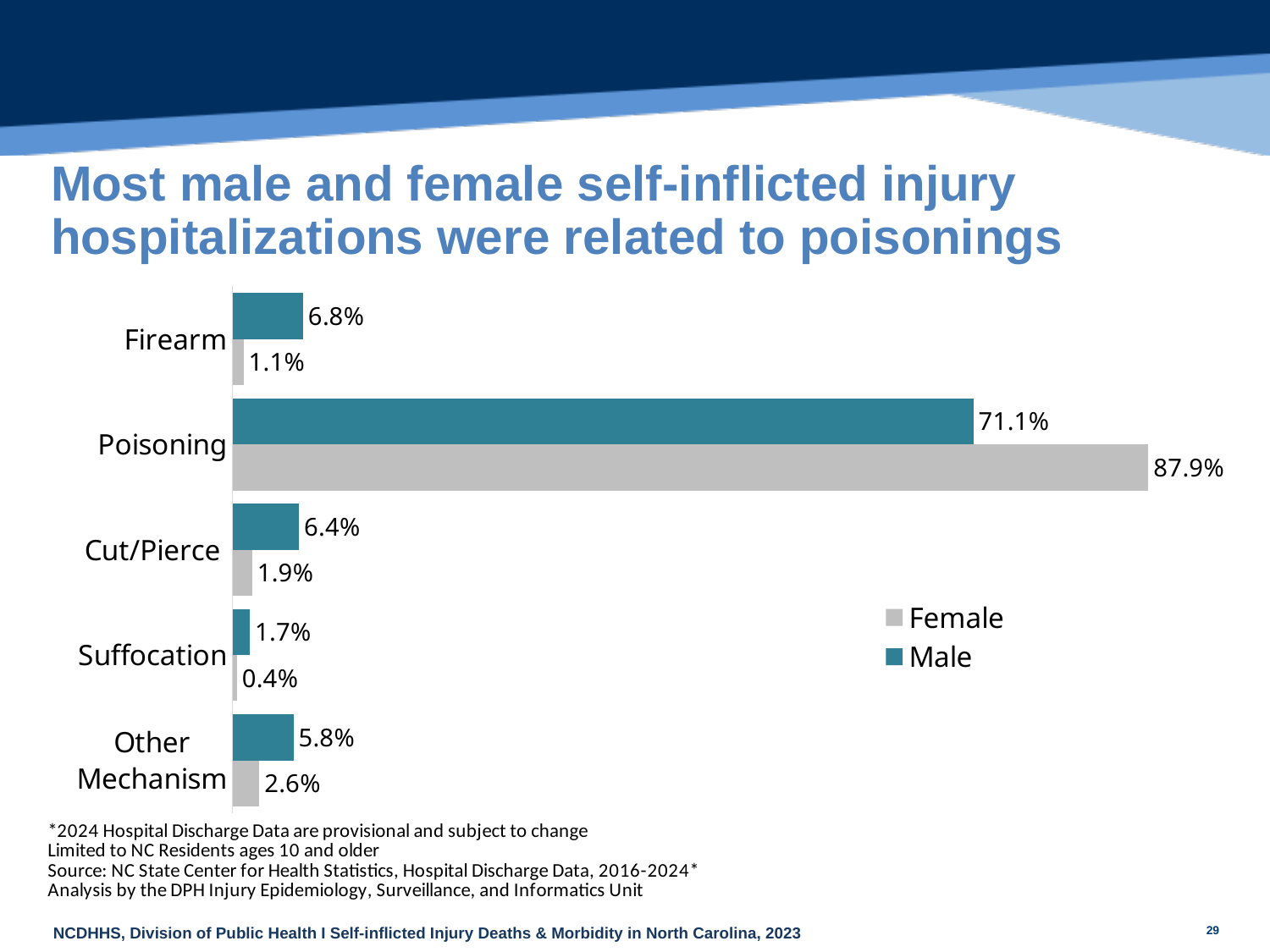
What is the Male value for Firearm? 6.8% Which mechanism has the highest Female percentage? Poisoning How many series does the legend list? 2 What percentage of male self-inflicted injury hospitalizations were related to poisoning? 71.1% How many mechanism categories are shown in the chart? 5 What type of chart is shown on the slide? Bar chart For Cut/Pierce, which is larger, the Male or the Female percentage? Male What is the difference between the Female and Male percentages for Poisoning? 16.8% What is the Female value for Suffocation? 0.4% What percentage of female self-inflicted injury hospitalizations were related to poisoning? 87.9% Which mechanism has the lowest Male percentage? Suffocation What is the Female value for Other Mechanism? 2.6%